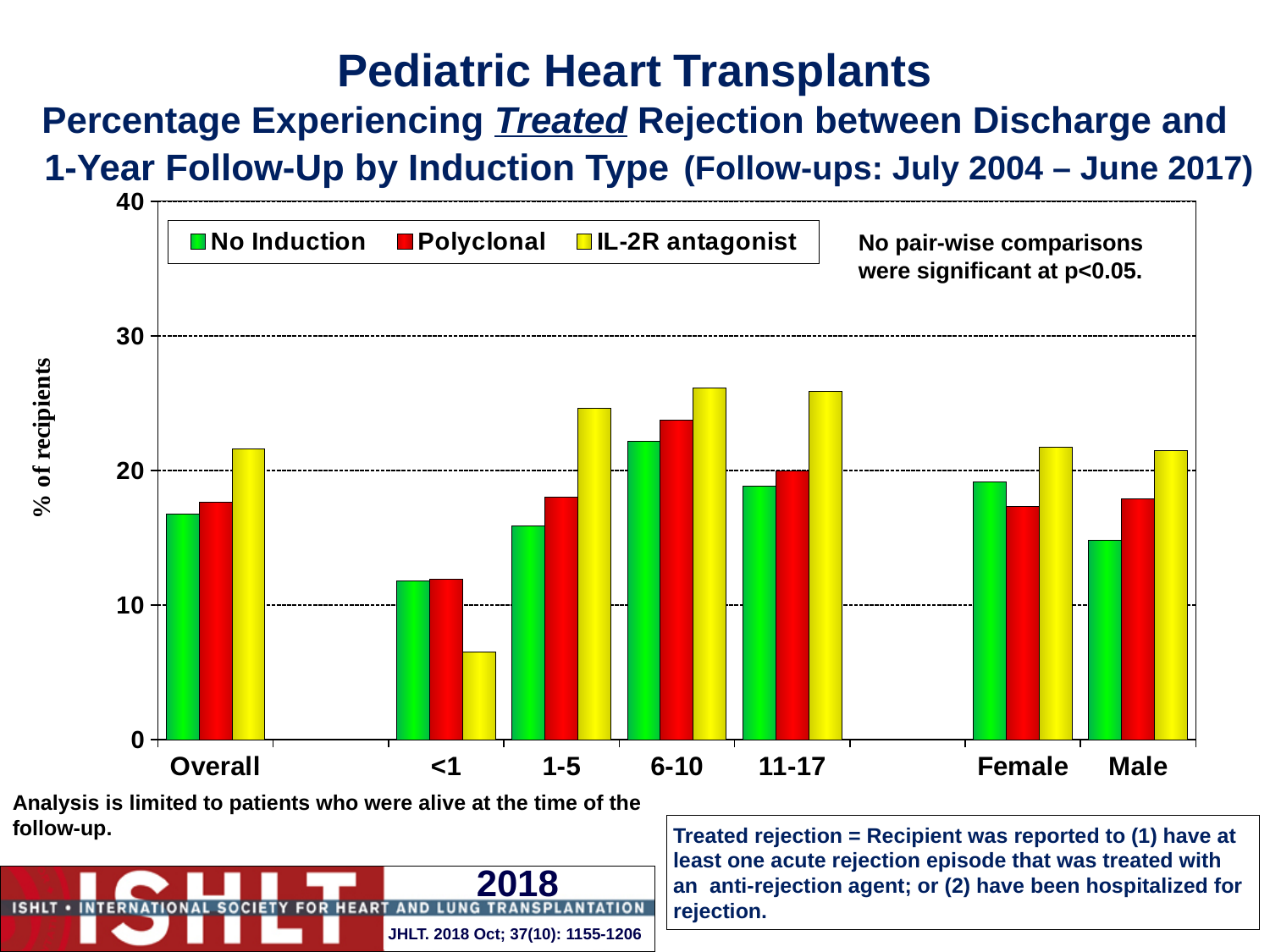
For Female recipients, which is larger: the No Induction value or the Polyclonal value? No Induction Is the IL-2R antagonist value for the 1-5 age group greater or less than 20? greater What is the label of the y axis? % of recipients For which category is the IL-2R antagonist value lowest? <1 Is the No Induction value for the 6-10 age group greater or less than 20? greater What kind of chart is shown on the slide? bar chart How many categories are shown along the x axis? 7 For which category is the No Induction value highest? 6-10 Within the <1 age group, which induction type has the lowest value? IL-2R antagonist How many series does the legend list? 3 Is the No Induction value for Male greater or less than 20? less